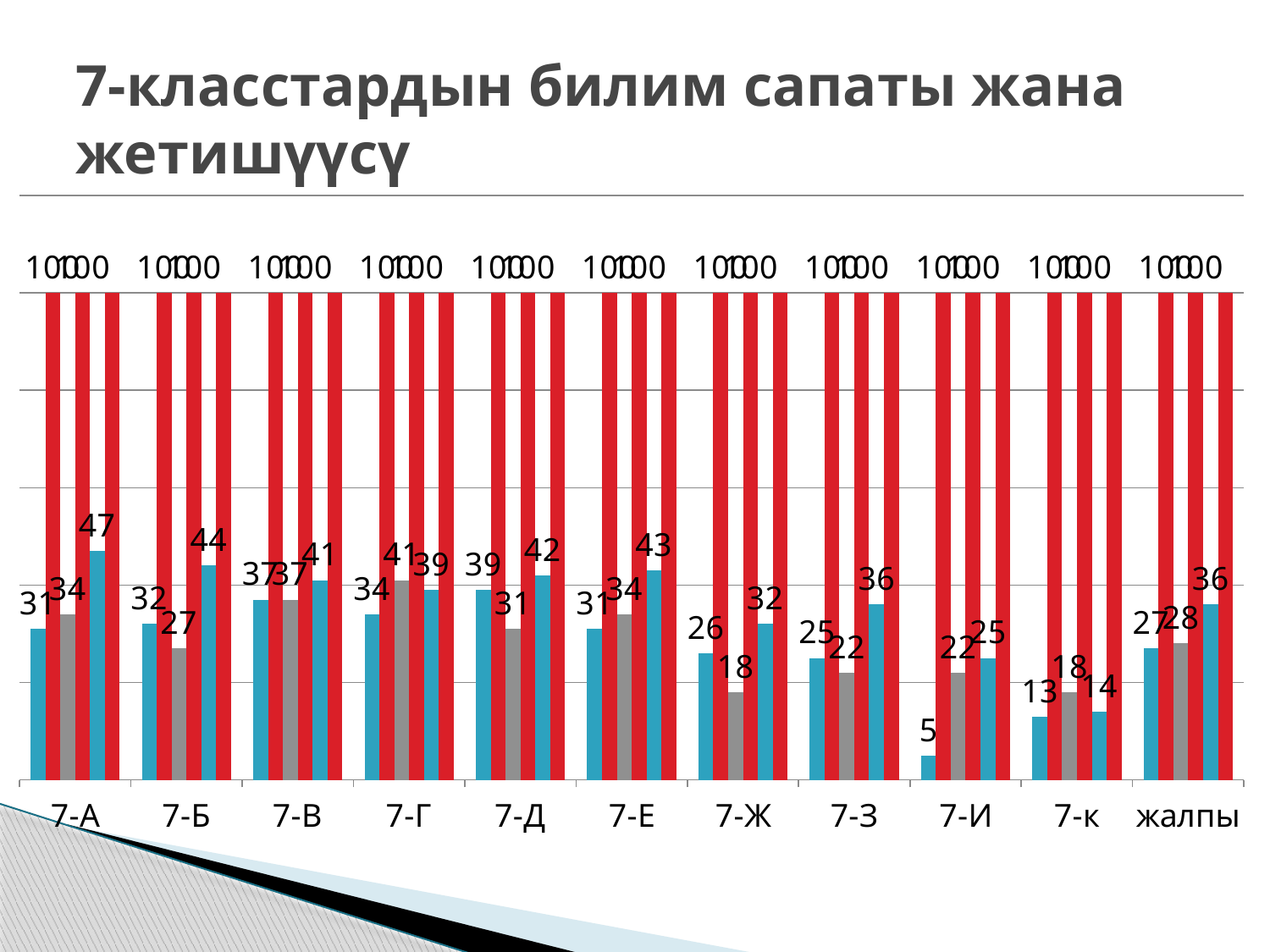
What is the value of the third (rightmost non-red) bar for 7-А? 47 What kind of chart is shown on the slide? bar chart How many categories are shown along the x axis of the chart? 11 What is the value of the third (rightmost non-red) bar for жалпы? 36 Which category has the lowest value for the first bar? 7-И What value do all the red bars reach? 100 What is the value of the gray bar for 7-Ж? 18 Which category has the highest value for the third (rightmost non-red) bar? 7-А For 7-Б, what is the difference between the third bar (44) and the gray bar (27)? 17 Which has the larger gray bar value, 7-Г or 7-Д? 7-Г What is the value of the first bar for 7-И? 5 What is the title of the slide? 7-класстардын билим сапаты жана жетишүүсү